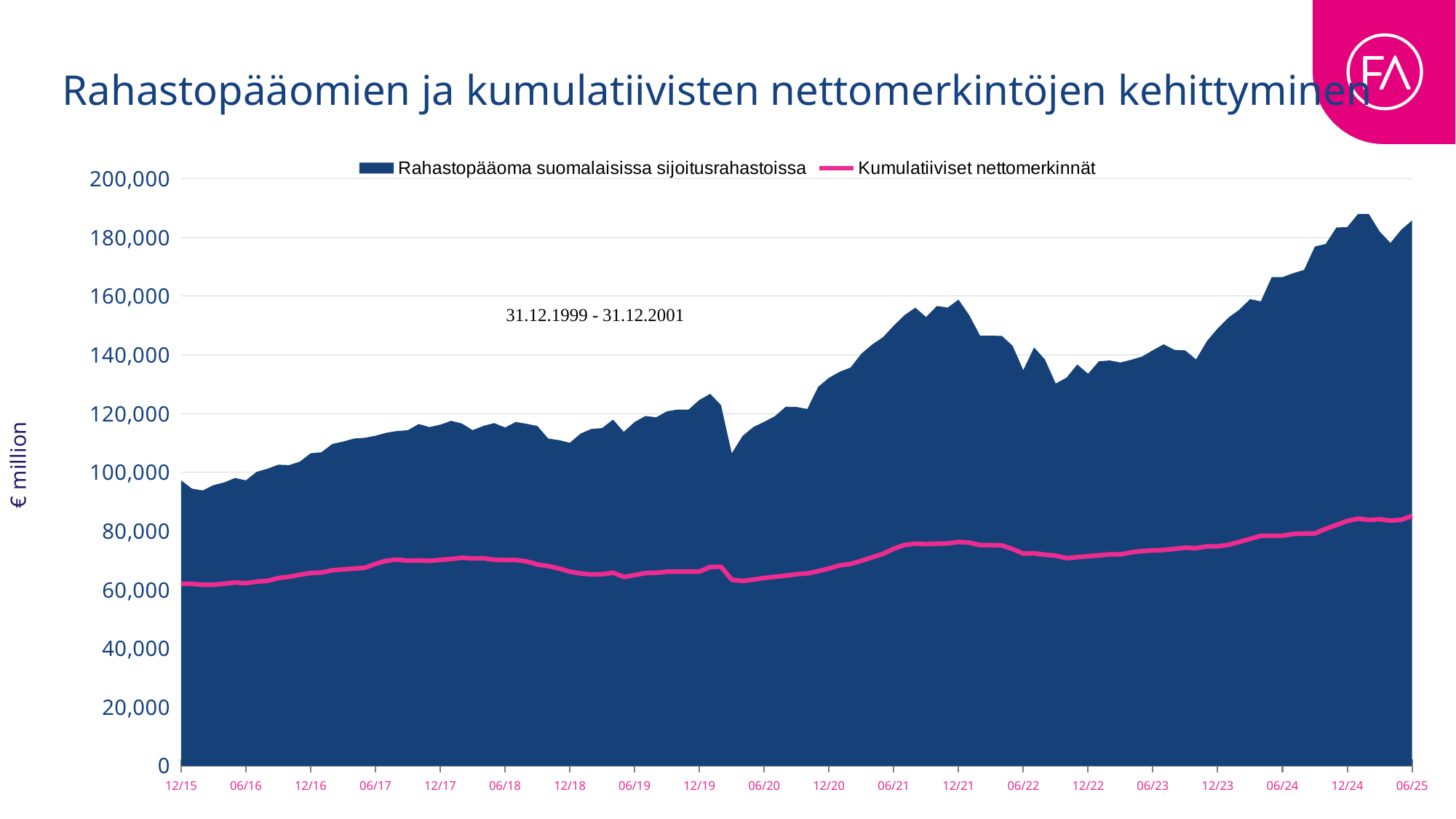
How many series does the legend list? 2 Is the value of Rahastopääoma suomalaisissa sijoitusrahastoissa at 06/25 greater or less than 180,000? greater Overall, does Kumulatiiviset nettomerkinnät rise or fall from 12/15 to 06/25? rise What are the two series named in the legend? Rahastopääoma suomalaisissa sijoitusrahastoissa; Kumulatiiviset nettomerkinnät Which series has the higher value at 06/25, Rahastopääoma suomalaisissa sijoitusrahastoissa or Kumulatiiviset nettomerkinnät? Rahastopääoma suomalaisissa sijoitusrahastoissa How many date labels are shown on the x axis? 20 Is the value of Kumulatiiviset nettomerkinnät at 12/21 greater or less than 80,000? less Is the value of Rahastopääoma suomalaisissa sijoitusrahastoissa at 12/21 greater or less than 140,000? greater What unit is shown on the vertical axis label? € million What kind of chart is shown on the slide? Area chart with a line series